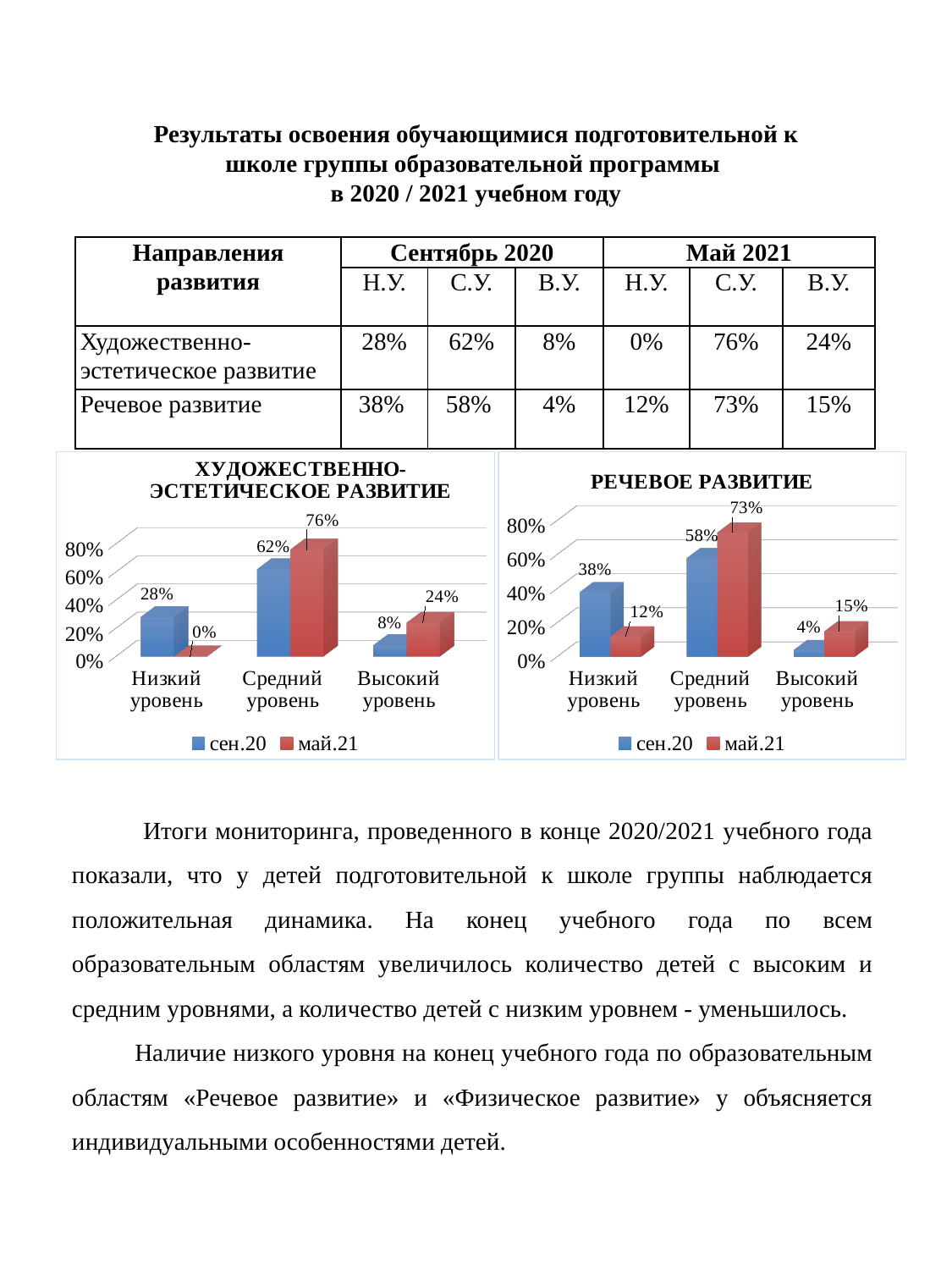
In the chart titled «РЕЧЕВОЕ РАЗВИТИЕ», which is larger for «Средний уровень»: the «сен.20» value or the «май.21» value? май.21 In the chart titled «РЕЧЕВОЕ РАЗВИТИЕ», what is the value for «Высокий уровень» in the «май.21» series? 15% In the chart titled «ХУДОЖЕСТВЕННО-ЭСТЕТИЧЕСКОЕ РАЗВИТИЕ», what is the difference between the «май.21» and «сен.20» values for «Высокий уровень»? 16% What kind of chart is the chart titled «РЕЧЕВОЕ РАЗВИТИЕ»? Bar chart In the chart titled «РЕЧЕВОЕ РАЗВИТИЕ», what is the value for «Низкий уровень» in the «сен.20» series? 38% In the chart titled «ХУДОЖЕСТВЕННО-ЭСТЕТИЧЕСКОЕ РАЗВИТИЕ», which category has the highest value in the «май.21» series? Средний уровень In the chart titled «ХУДОЖЕСТВЕННО-ЭСТЕТИЧЕСКОЕ РАЗВИТИЕ», what is the value for «Средний уровень» in the «май.21» series? 76% How many categories are shown on the x axis of the chart titled «РЕЧЕВОЕ РАЗВИТИЕ»? 3 In the chart titled «РЕЧЕВОЕ РАЗВИТИЕ», which category has the lowest value in the «сен.20» series? Высокий уровень In the chart titled «РЕЧЕВОЕ РАЗВИТИЕ», what is the difference between the «сен.20» and «май.21» values for «Низкий уровень»? 26% How many series does the legend list in the chart titled «ХУДОЖЕСТВЕННО-ЭСТЕТИЧЕСКОЕ РАЗВИТИЕ»? 2 In the chart titled «ХУДОЖЕСТВЕННО-ЭСТЕТИЧЕСКОЕ РАЗВИТИЕ», what is the value for «Низкий уровень» in the «сен.20» series? 28%